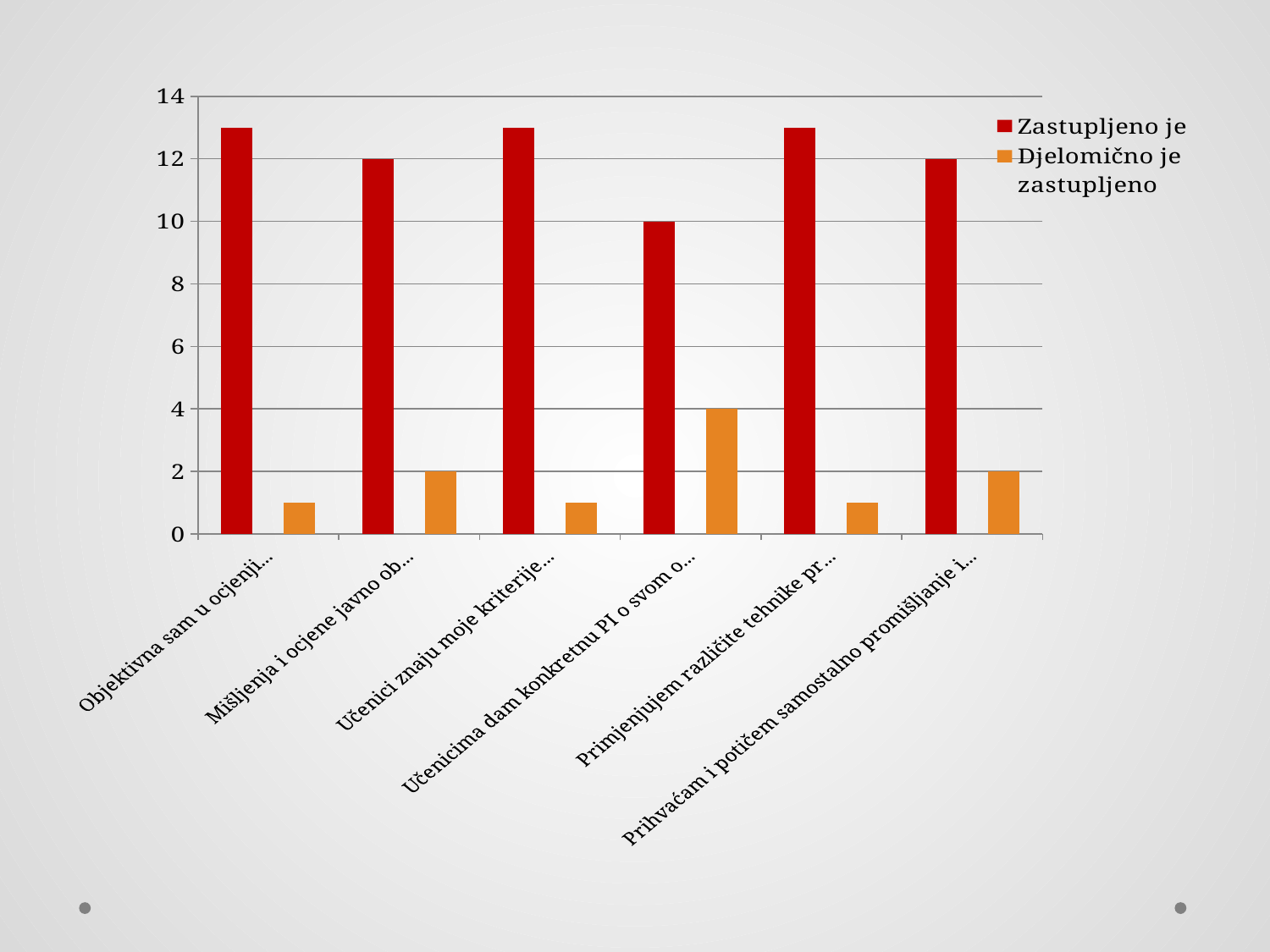
Which category has the highest value for "Djelomično je zastupljeno"? Učenicima dam konkretnu PI o svom o... What is the value of "Zastupljeno je" for the category "Mišljenja i ocjene javno ob..."? 12 What is the value of "Djelomično je zastupljeno" for the category "Učenicima dam konkretnu PI o svom o..."? 4 How many series does the legend list? 2 What kind of chart is shown on the slide? bar chart Is the value of "Zastupljeno je" for "Objektivna sam u ocjenji..." greater or less than 12? greater Which category has the lowest value for "Zastupljeno je"? Učenicima dam konkretnu PI o svom o... What is the value of "Djelomično je zastupljeno" for the category "Prihvaćam i potičem samostalno promišljanje i..."? 2 How many categories are shown on the x axis? 6 What is the value of "Zastupljeno je" for the category "Učenicima dam konkretnu PI o svom o..."? 10 What is the difference between "Zastupljeno je" and "Djelomično je zastupljeno" for the category "Učenicima dam konkretnu PI o svom o..."? 6 Which series is shown in orange in the legend? Djelomično je zastupljeno